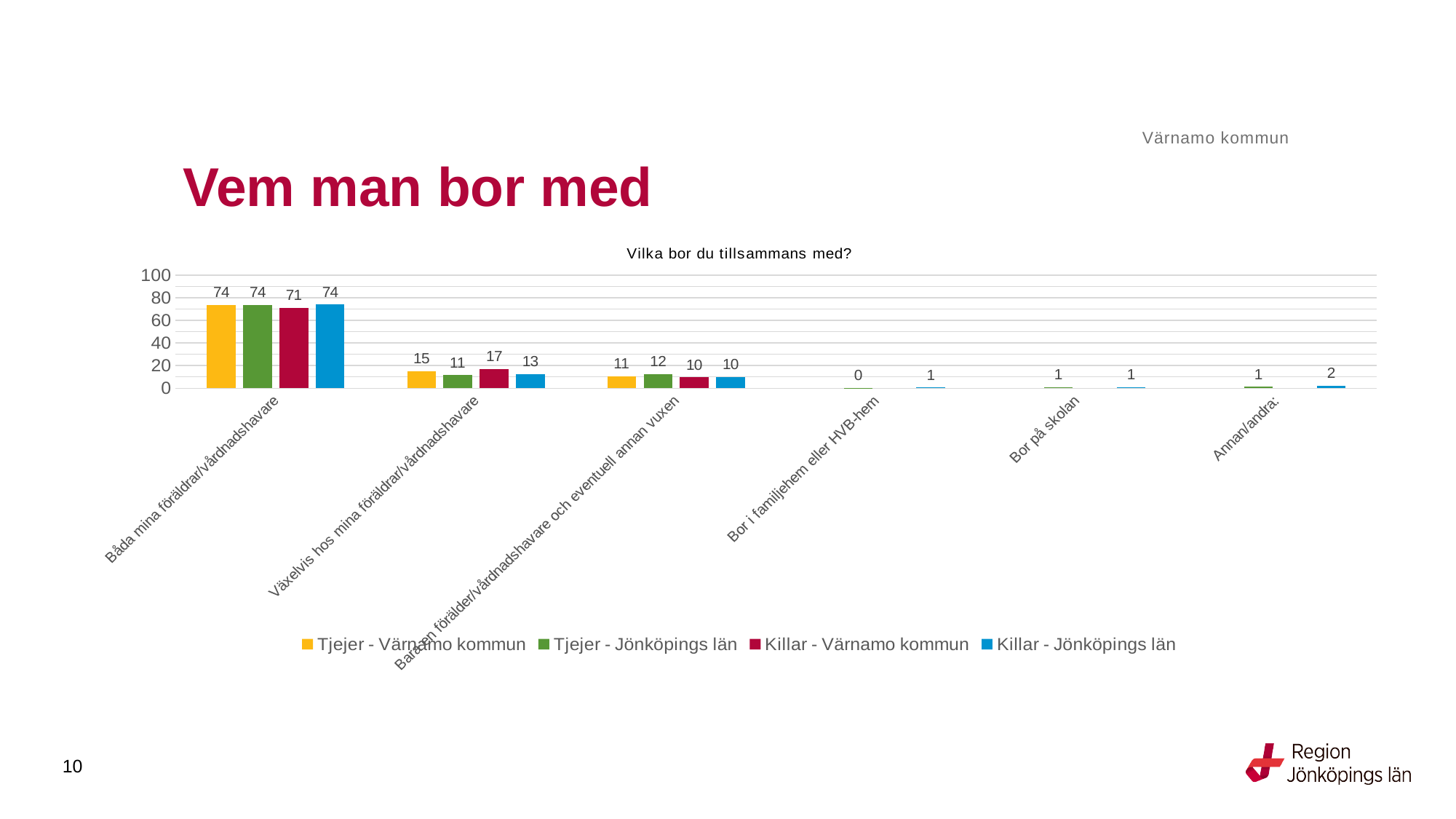
What is the value for Killar - Jönköpings län in the category 'Annan/andra'? 2 Which is larger in the category 'Växelvis hos mina föräldrar/vårdnadshavare': Tjejer - Värnamo kommun or Killar - Jönköpings län? Tjejer - Värnamo kommun What is the value for Tjejer - Värnamo kommun in the category 'Båda mina föräldrar/vårdnadshavare'? 74 How many series does the legend list? 4 Which series has the lowest value in the category 'Båda mina föräldrar/vårdnadshavare'? Killar - Värnamo kommun What is the difference between Killar - Värnamo kommun and Tjejer - Jönköpings län in the category 'Växelvis hos mina föräldrar/vårdnadshavare'? 6 What is the value for Tjejer - Jönköpings län in the category 'Bara en förälder/vårdnadshavare och eventuell annan vuxen'? 12 What is the value for Killar - Värnamo kommun in the category 'Växelvis hos mina föräldrar/vårdnadshavare'? 17 What is the title of the chart? Vilka bor du tillsammans med? Which series has the highest value in the category 'Växelvis hos mina föräldrar/vårdnadshavare'? Killar - Värnamo kommun What is the value for Killar - Värnamo kommun in the category 'Båda mina föräldrar/vårdnadshavare'? 71 What type of chart is shown on the slide? bar chart